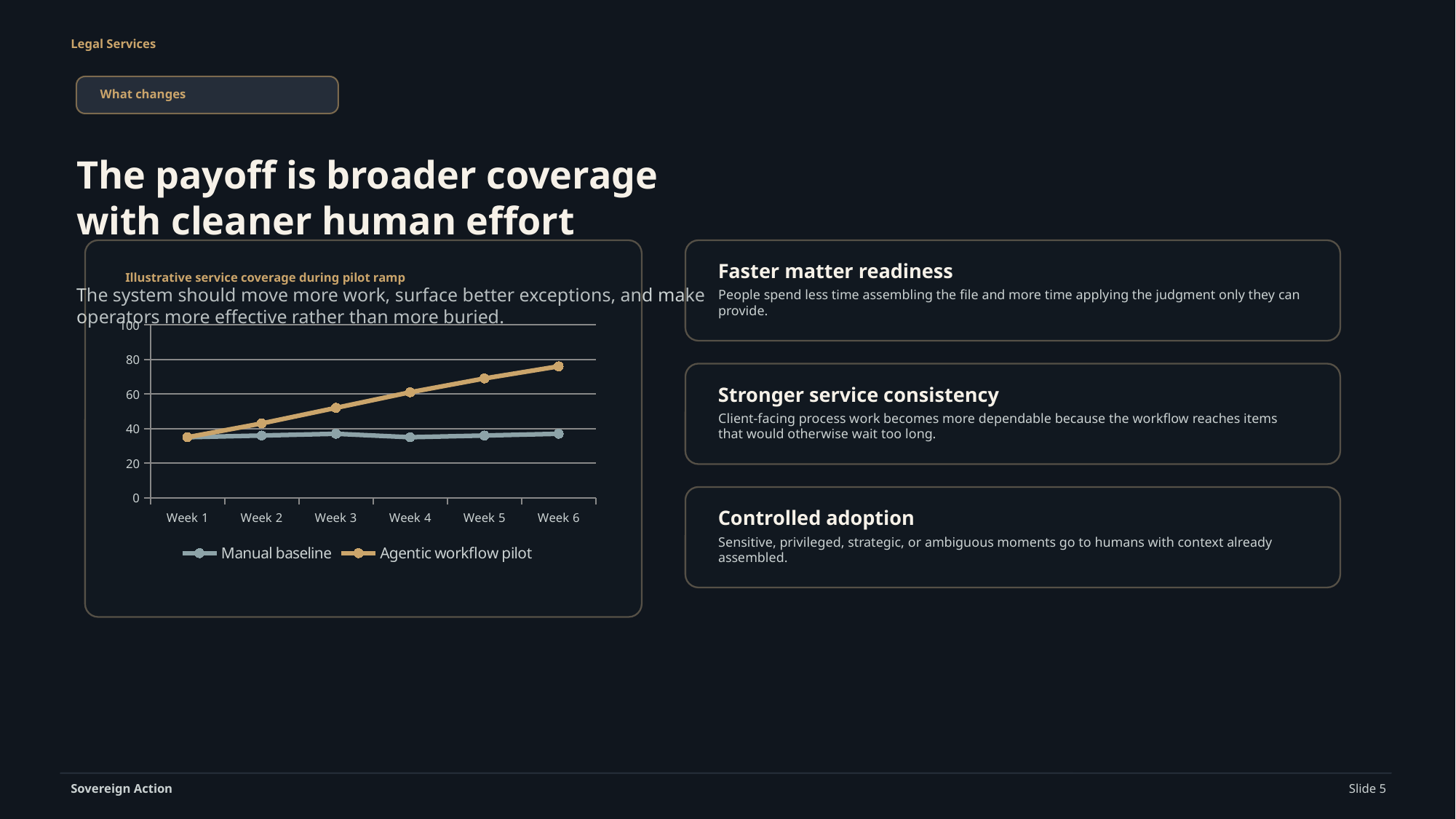
What is the title of the chart? Illustrative service coverage during pilot ramp Is the Agentic workflow pilot value for Week 3 greater or less than 40? greater Is the Agentic workflow pilot value for Week 6 greater or less than 60? greater Does the Agentic workflow pilot series rise or fall from Week 1 to Week 6? Rise What kind of chart is shown on the slide? Line chart Is the Manual baseline value for Week 4 greater or less than 40? less How many weeks are plotted along the x axis of the chart? 6 In which week does the Agentic workflow pilot series reach its highest value? Week 6 Which two series are listed in the chart legend? Manual baseline and Agentic workflow pilot In which week is the Agentic workflow pilot series at its lowest value? Week 1 How many series does the chart legend list? 2 At Week 6, which series has the larger value, Manual baseline or Agentic workflow pilot? Agentic workflow pilot